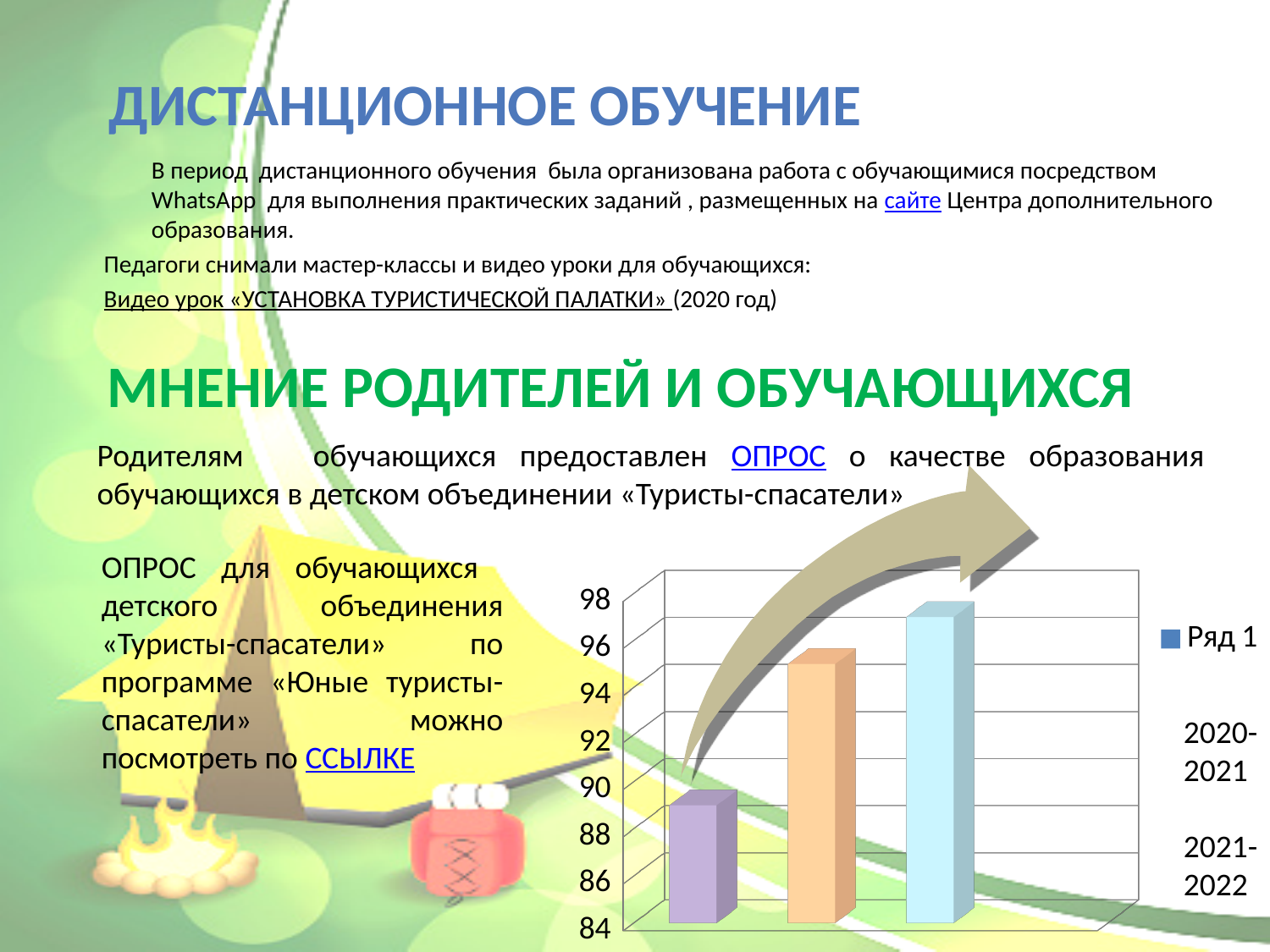
Do the bar values rise or fall from left to right across the chart? rise What is the name of the series shown in the chart legend? Ряд 1 What is the highest value shown on the chart's vertical axis? 98 Which bar is the tallest in the chart: the leftmost (purple), the middle (orange) or the rightmost (blue)? the rightmost (blue) Which bar is the shortest in the chart: the leftmost (purple), the middle (orange) or the rightmost (blue)? the leftmost (purple) What kind of chart is shown on the slide? bar chart Is the value of the leftmost (purple) bar greater or less than 92? less How many series does the chart legend list? 1 Which is larger: the middle (orange) bar or the leftmost (purple) bar? the middle (orange) bar How many bars are plotted in the chart? 3 Is the value of the middle (orange) bar greater or less than 94? greater Is the value of the rightmost (blue) bar greater or less than 96? greater